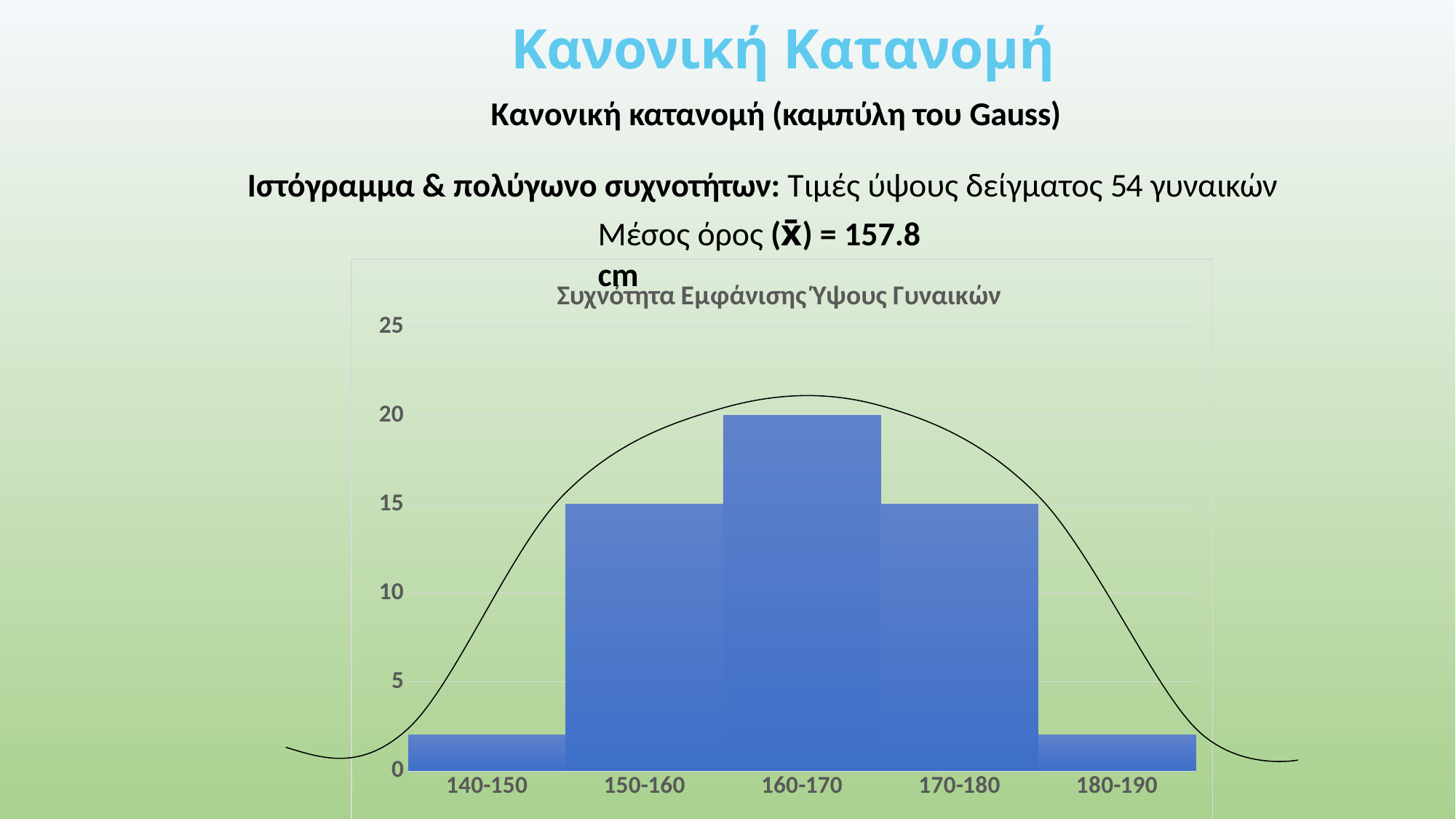
Is the value for 180-190 greater or less than 5? less Which category has a larger frequency, 160-170 or 150-160? 160-170 Is the value for 160-170 greater or less than 15? greater Is the value for 140-150 greater or less than 5? less Which height category has the highest frequency in the chart? 160-170 What is the title of the chart? Συχνότητα Εμφάνισης Ύψους Γυναικών What is the frequency for the 150-160 category? 15 What is the frequency for the 170-180 category? 15 What is the difference between the frequencies of 160-170 and 170-180? 5 What kind of chart is shown on the slide? bar chart How many height categories are shown on the x axis of the chart? 5 What is the frequency for the 160-170 category? 20